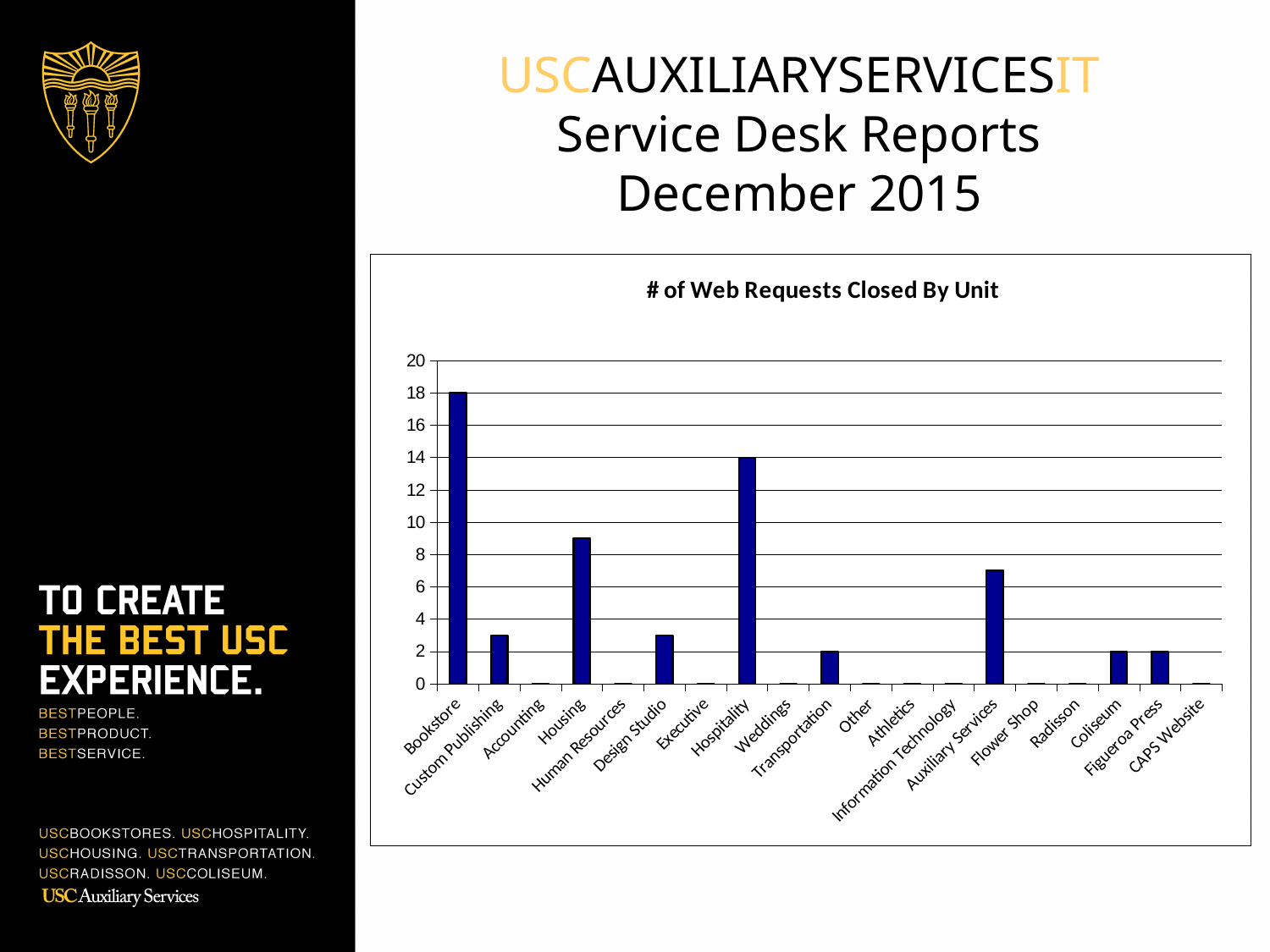
Is the value for Housing greater or less than 8? greater Which unit has the highest number of web requests closed? Bookstore How many web requests were closed by Hospitality? 14 What kind of chart is shown on the slide? bar chart Which unit closed more web requests, Housing or Auxiliary Services? Housing How many web requests were closed by Bookstore? 18 How many web requests were closed by Transportation? 2 What is the title of the chart? # of Web Requests Closed By Unit Is the value for Custom Publishing greater or less than 4? less How many units are listed along the x axis of the chart? 19 What is the difference between the number of web requests closed by Bookstore and by Hospitality? 4 How many web requests were closed by Figueroa Press? 2